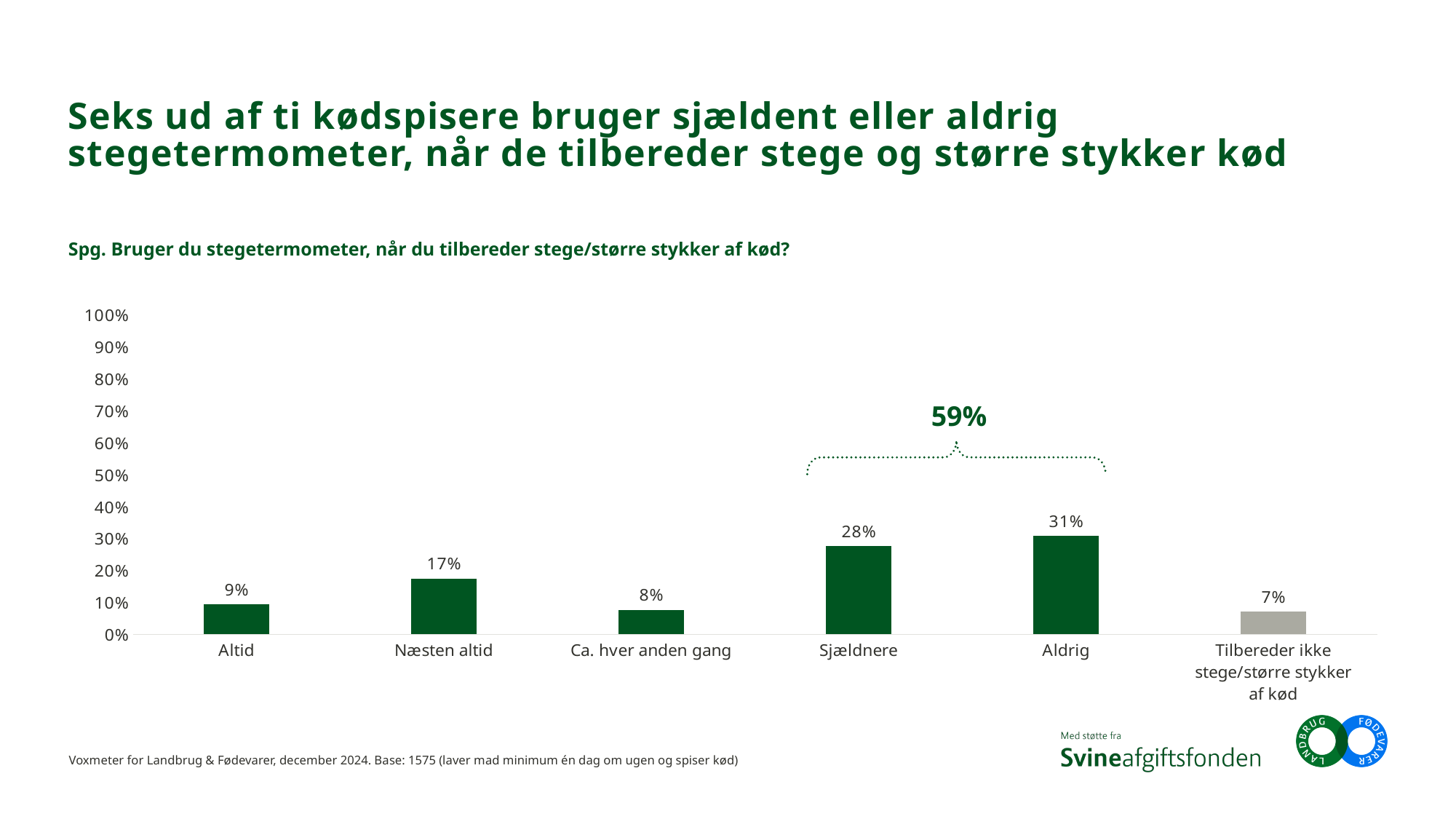
What is the value for 'Tilbereder ikke stege/større stykker af kød'? 7% What kind of chart is shown on the slide? Bar chart How many categories are shown on the x axis? 6 What is the difference between the values for 'Aldrig' and 'Sjældnere'? 3 percentage points What is the value shown for 'Næsten altid'? 17% Which category has the lowest value? Tilbereder ikke stege/større stykker af kød Which is larger, the value for 'Altid' or the value for 'Ca. hver anden gang'? Altid What percentage of respondents answered 'Aldrig'? 31% What combined percentage is shown above the bracket spanning 'Sjældnere' and 'Aldrig'? 59% Which category has the highest value? Aldrig Which bar is coloured grey instead of green? Tilbereder ikke stege/større stykker af kød Is the value for 'Sjældnere' greater or less than 20%? greater